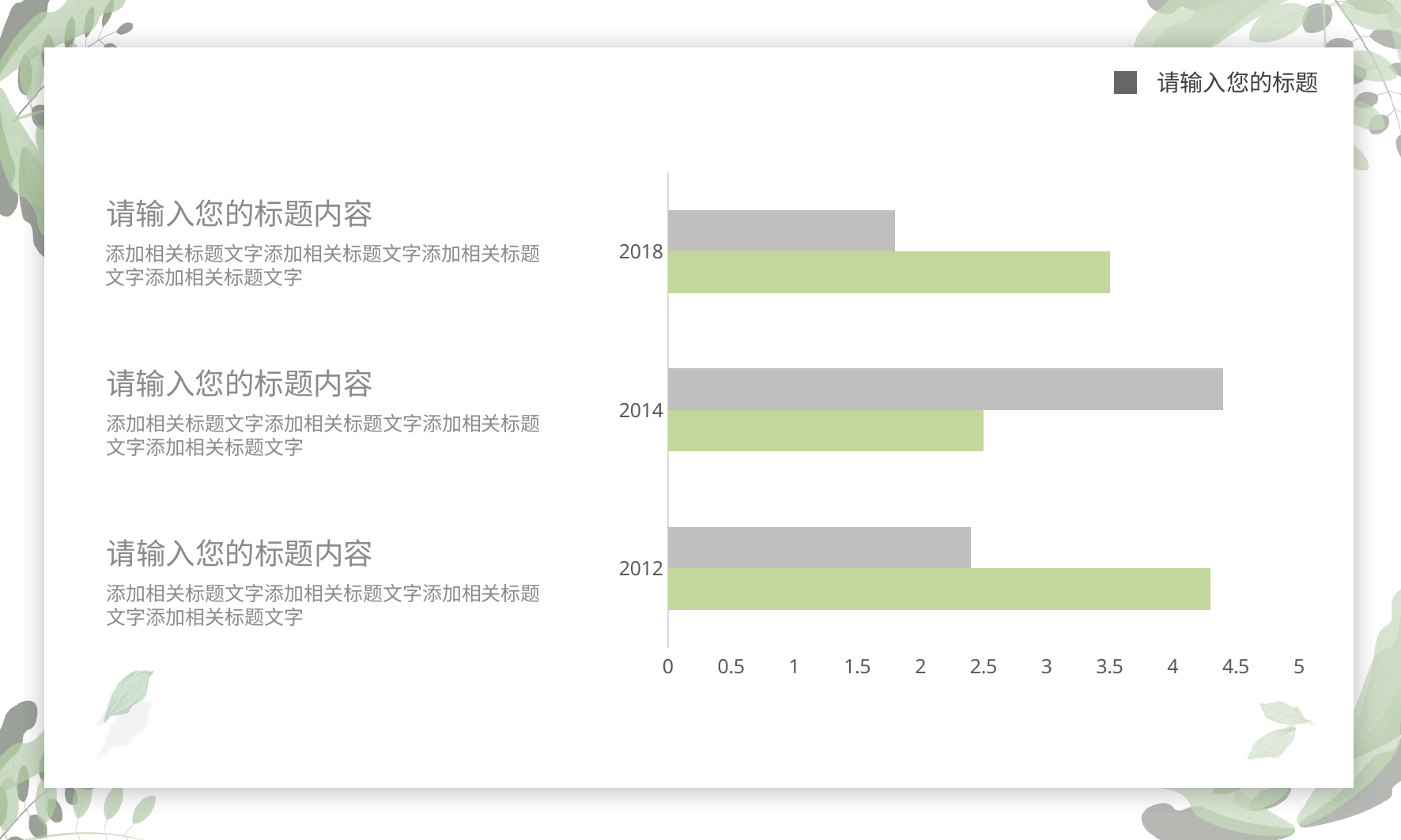
For 2014, which bar is larger, the gray bar or the green bar? the gray bar Is the value of the gray bar for 2018 greater or less than 2? less What is the difference between the green bar for 2018 and the green bar for 2014? 1 What is the value of the green bar for 2014? 2.5 Which year has the longest green bar? 2012 What is the highest value shown on the horizontal axis? 5 Is the value of the gray bar for 2014 greater or less than 4? greater Is the value of the green bar for 2012 greater or less than 4? greater Which year has the longest gray bar? 2014 What is the value of the green bar for 2018? 3.5 How many year categories are shown on the chart? 3 What kind of chart is shown on the slide? bar chart